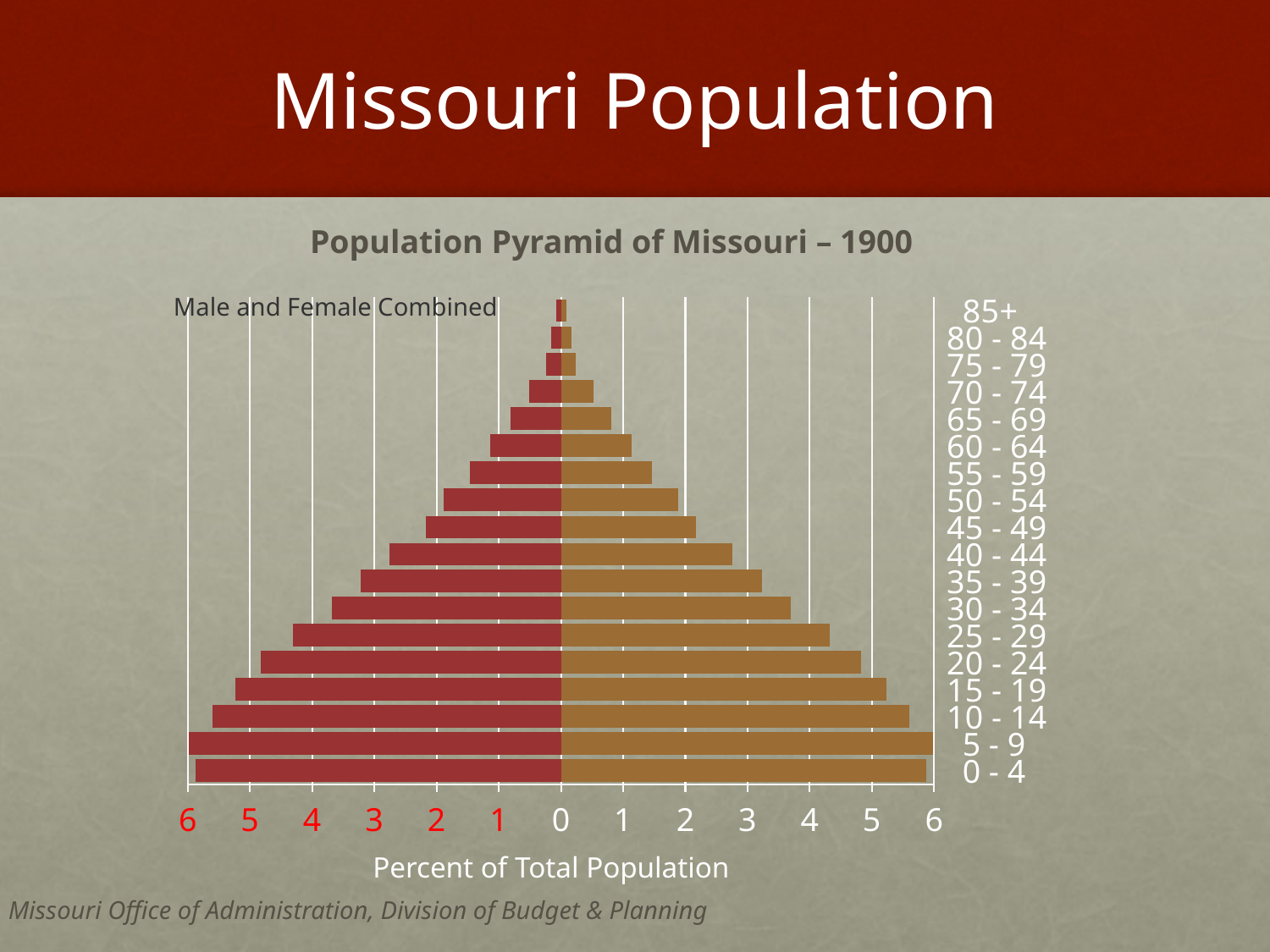
Which age group has a larger share of the population, 0 - 4 or 40 - 44? 0 - 4 What kind of chart is shown on the slide? bar chart How many age groups are shown on the chart? 18 Is the value for the 0 - 4 age group on the right (gold) side greater or less than 5? greater Do the bars generally get longer or shorter as the age groups get older? shorter Is the value for the 45 - 49 age group on the right (gold) side greater or less than 3? less What is the title of the chart? Population Pyramid of Missouri – 1900 What is the label on the horizontal axis of the chart? Percent of Total Population Which age group has the smallest share of the population? 85+ Is the value for the 60 - 64 age group on the right (gold) side greater or less than 2? less